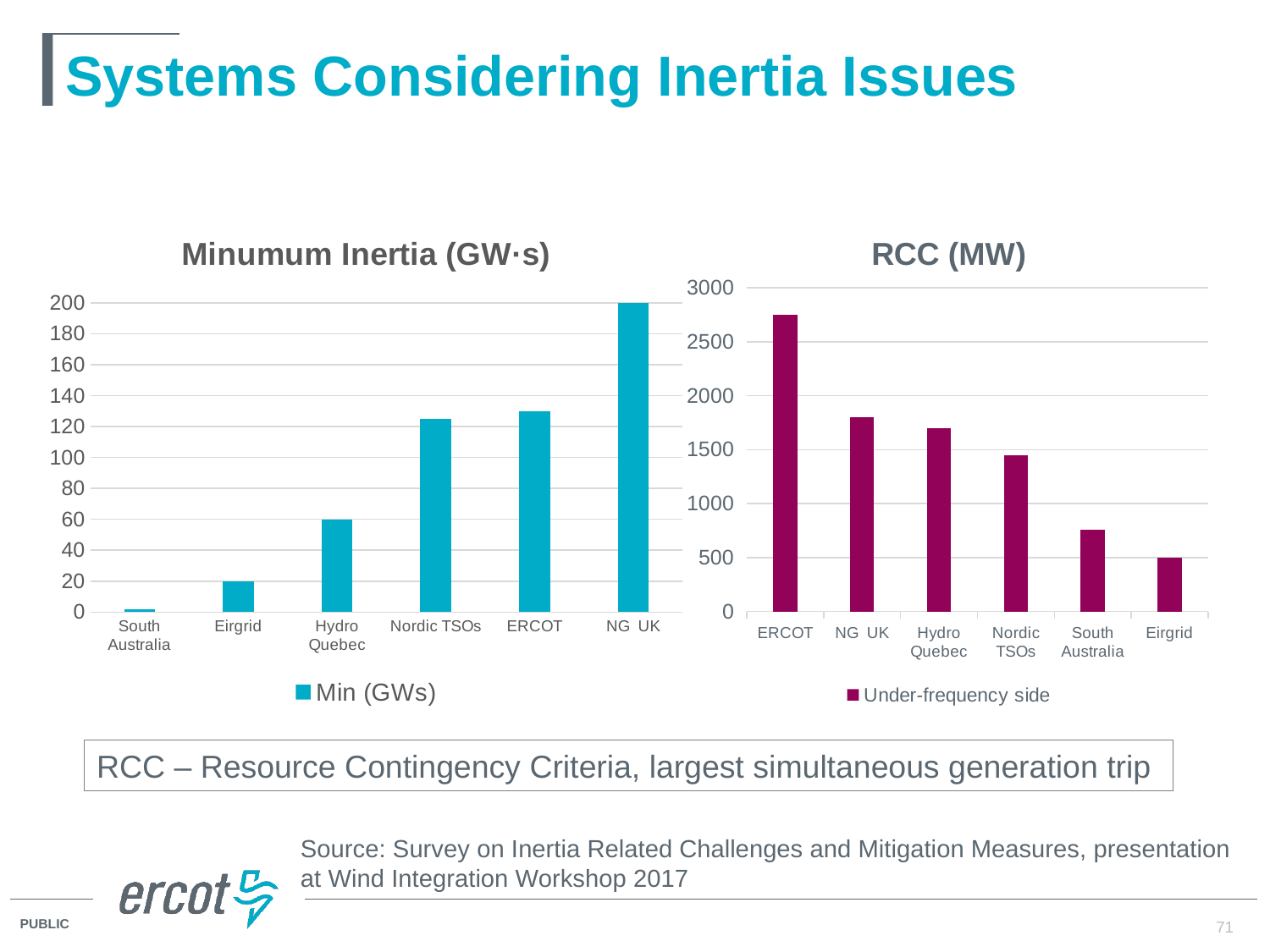
In the 'Minumum Inertia (GW·s)' chart, which system has the lowest minimum inertia? South Australia In the 'RCC (MW)' chart, is the value for ERCOT greater or less than 2500? greater In the 'RCC (MW)' chart, which system has the highest RCC? ERCOT How many systems are shown in the 'Minumum Inertia (GW·s)' chart? 6 In the 'Minumum Inertia (GW·s)' chart, what is the value for Eirgrid? 20 In the 'Minumum Inertia (GW·s)' chart, what is the value for NG UK? 200 In the 'Minumum Inertia (GW·s)' chart, is the value for Nordic TSOs greater or less than 100? greater In the 'RCC (MW)' chart, which system has the lowest RCC? Eirgrid How many series does the legend of the 'RCC (MW)' chart list? 1 In the 'RCC (MW)' chart, which is larger, the value for NG UK or the value for South Australia? NG UK What kind of chart is the 'Minumum Inertia (GW·s)' chart? bar chart In the 'Minumum Inertia (GW·s)' chart, which system has the highest minimum inertia? NG UK